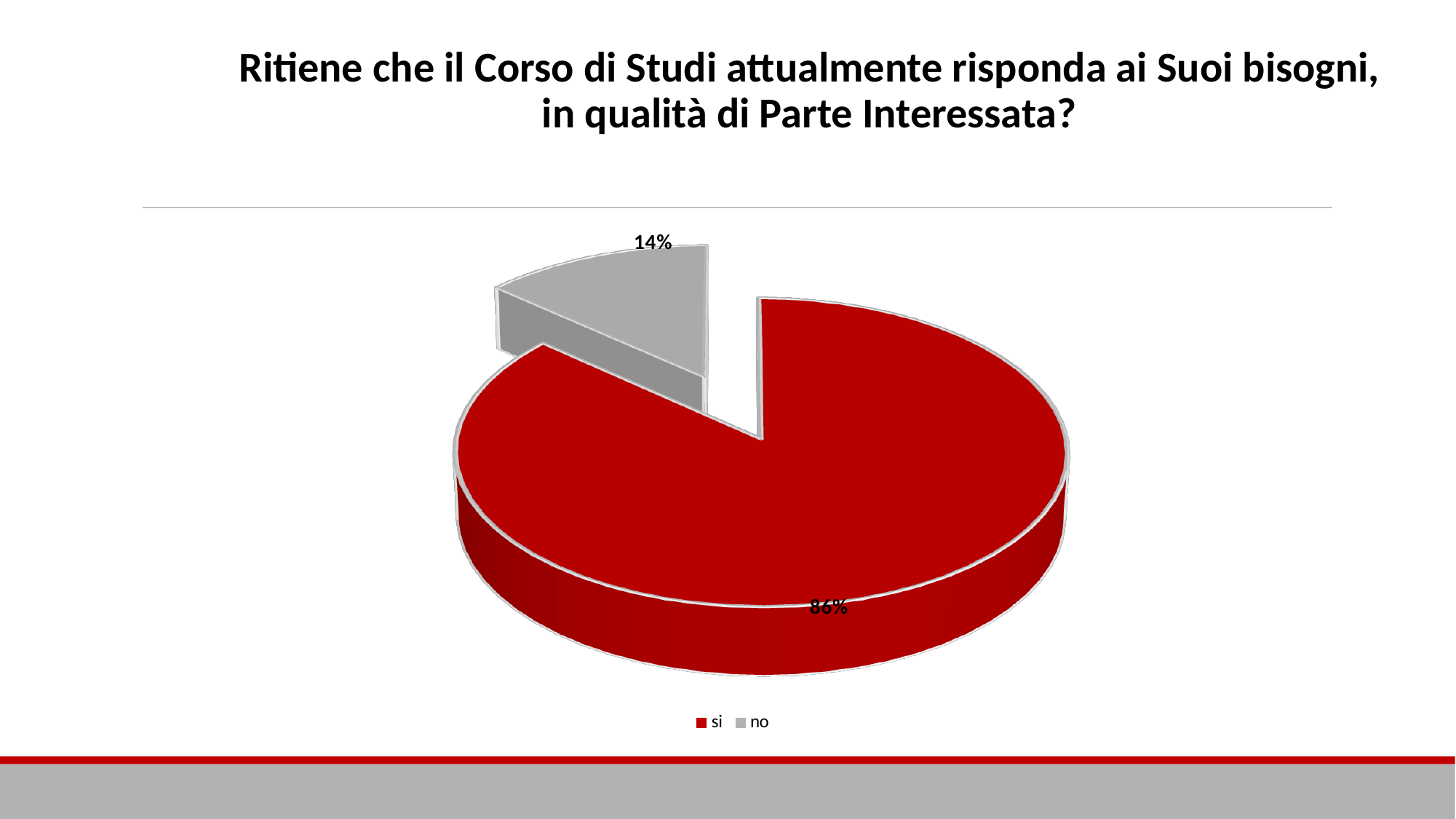
What share of the pie does the "no" slice represent? 14% What colour is the "si" slice? red How many slices does the pie chart have? 2 Which response has the smallest share of the pie? no How many entries does the legend list? 2 Which response has the largest share of the pie? si What percentage of respondents answered "no"? 14% What is the difference in percentage points between the "si" and "no" slices? 72 What kind of chart is shown on the slide? pie chart Which slice is larger, "si" or "no"? si What colour is the "no" slice? grey What percentage of respondents answered "si"? 86%